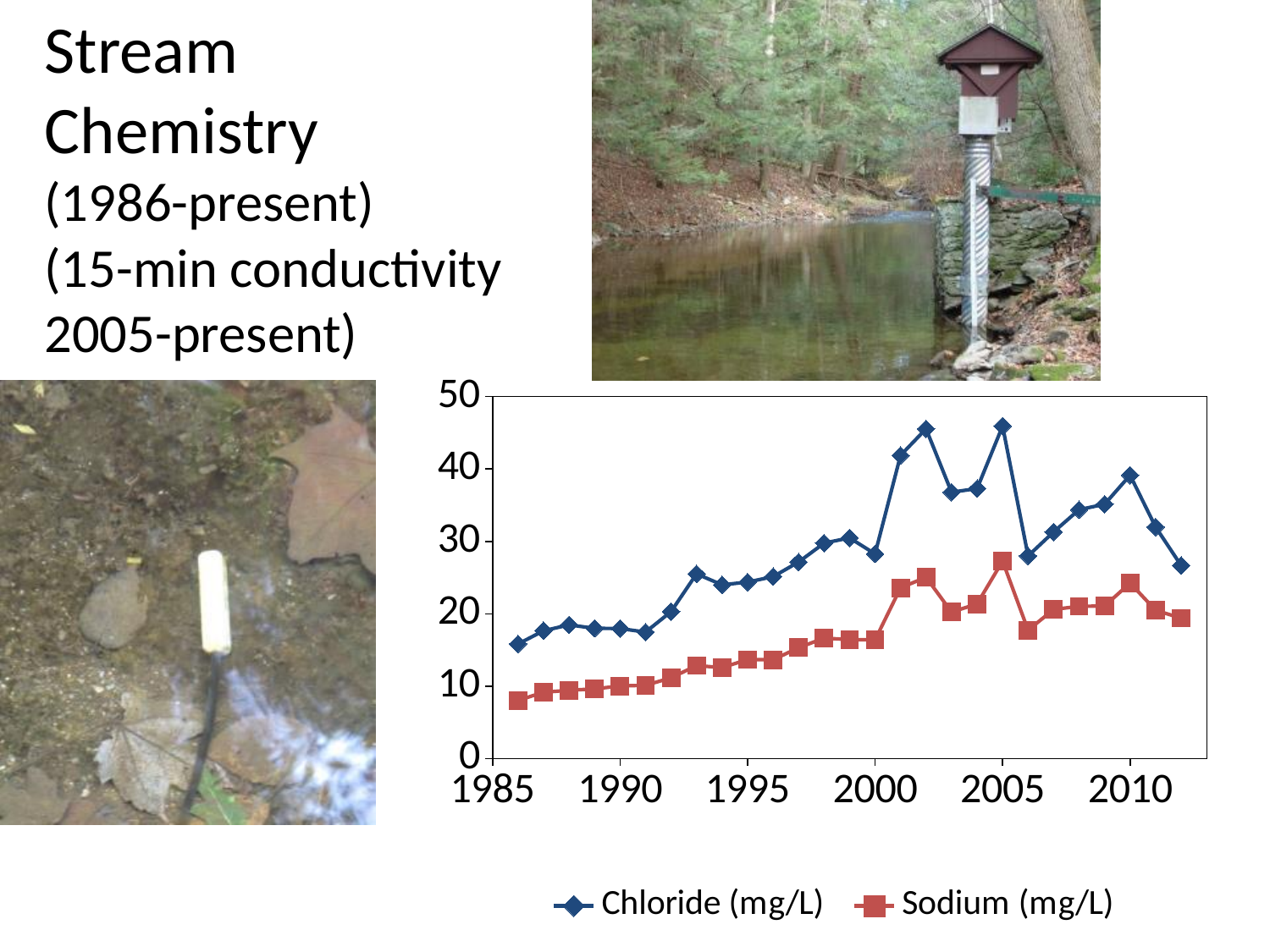
In which year is the Chloride (mg/L) value lowest? 1986 Is the Sodium (mg/L) value for 1986 greater or less than 10? less Is the Chloride (mg/L) value for 2001 greater or less than 40? greater In which year is the Sodium (mg/L) value lowest? 1986 What kind of chart is shown on the slide? line chart Does the Chloride (mg/L) series generally rise or fall from 1986 to 2001? rise What are the two series named in the chart's legend? Chloride (mg/L) and Sodium (mg/L) Is the Chloride (mg/L) value for 2012 greater or less than 30? less How many series does the chart's legend list? 2 In 2000, which series has the larger value, Chloride (mg/L) or Sodium (mg/L)? Chloride (mg/L) In which year does the Sodium (mg/L) series reach its highest value? 2005 What colour is the Sodium (mg/L) series plotted in? red